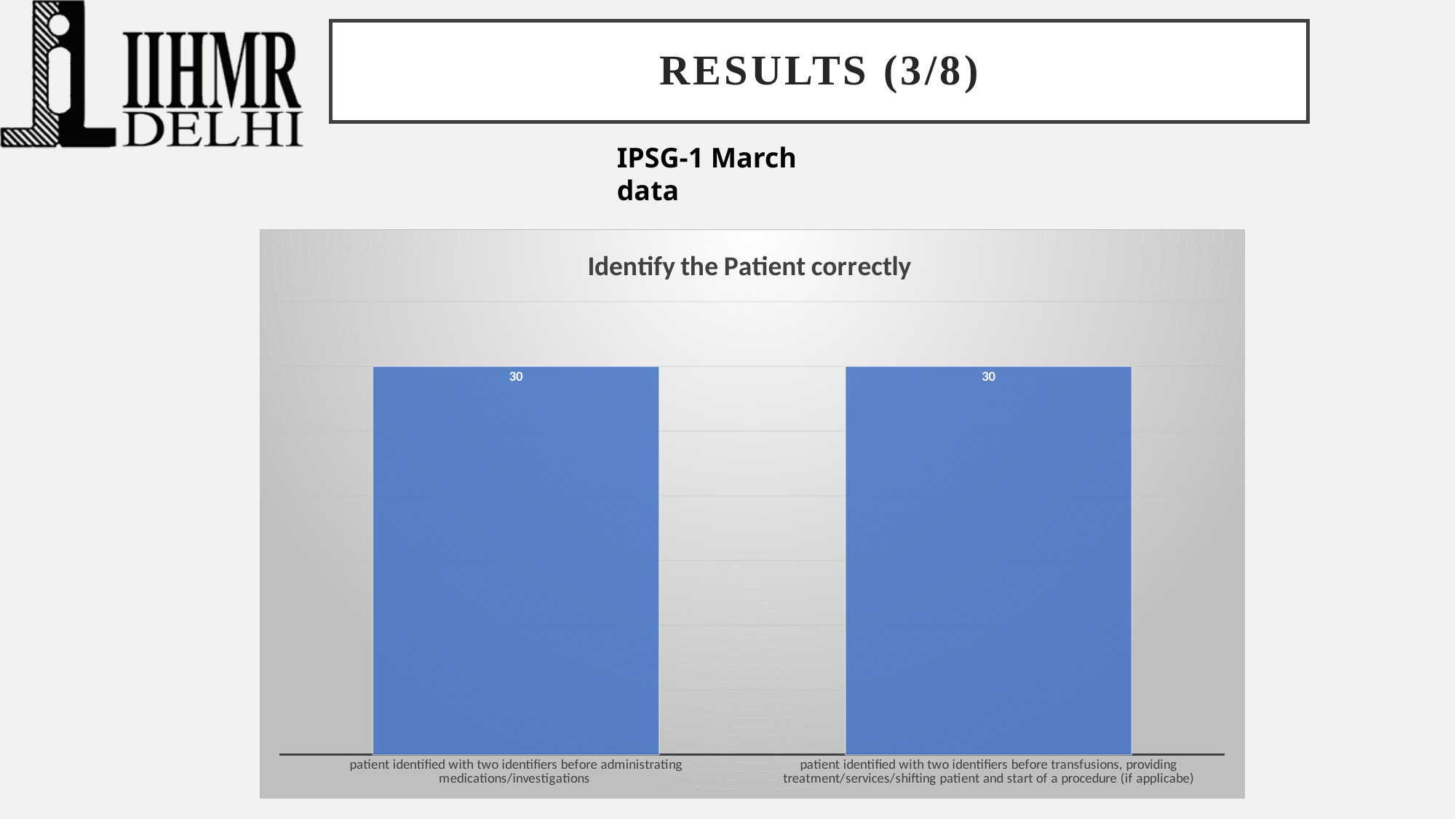
Do the two bars have the same value? Yes What colour are the bars in the chart? Blue What is the title of the chart? Identify the Patient correctly What kind of chart is shown on the slide? bar chart What is the value for 'patient identified with two identifiers before transfusions, providing treatment/services/shifting patient and start of a procedure (if applicabe)'? 30 What is the value for 'patient identified with two identifiers before administrating medications/investigations'? 30 What is the difference between the two bars' values? 0 How many categories are shown in the chart? 2 What is the total of the two bar values? 60